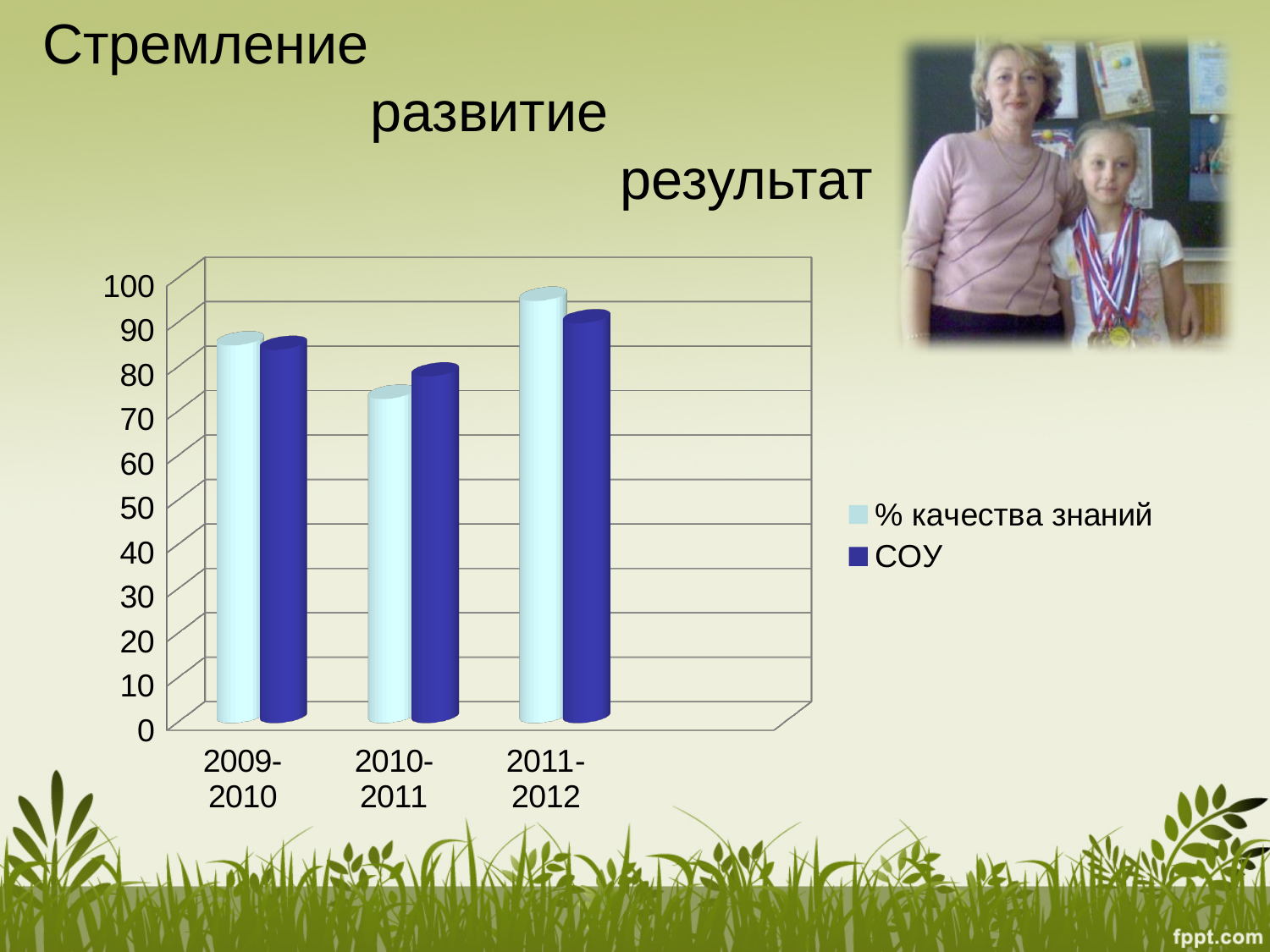
What kind of chart is shown on the slide? bar chart In which school year is the value for % качества знаний the lowest? 2010-2011 Which series are listed in the chart legend? % качества знаний and СОУ In which school year is the value for % качества знаний the highest? 2011-2012 In which school year is the value for СОУ the lowest? 2010-2011 In which school year is the value for СОУ the highest? 2011-2012 Which is larger in 2010-2011: the value for % качества знаний or the value for СОУ? СОУ Is the value for % качества знаний in 2010-2011 greater or less than 80? less Is the value for СОУ in 2011-2012 greater or less than 80? greater How many school-year categories are shown on the x axis of the chart? 3 Is the value for % качества знаний in 2011-2012 greater or less than 90? greater How many series does the chart legend list? 2